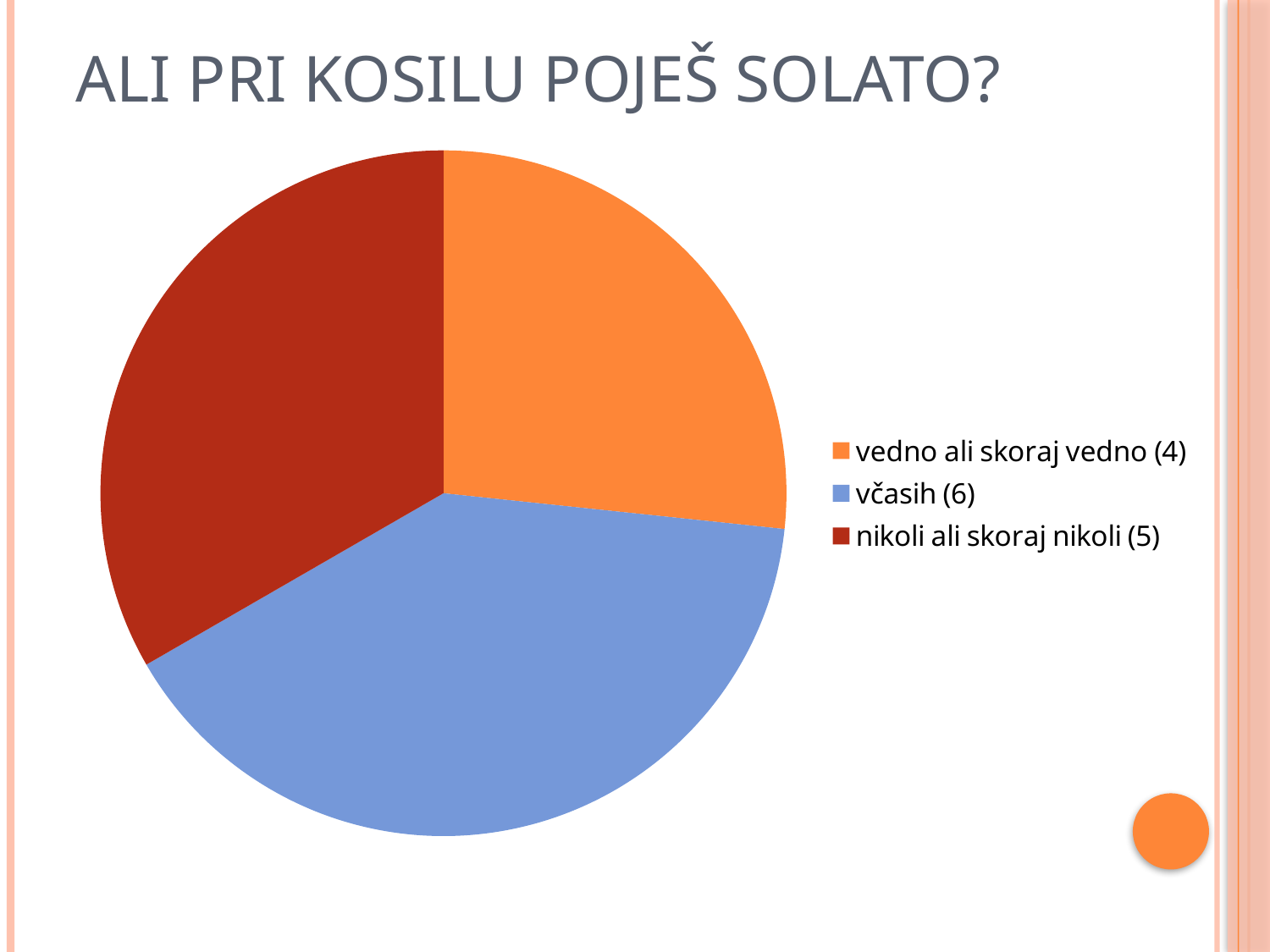
What share of the pie does "včasih" represent? 40% What is the value for "vedno ali skoraj vedno"? 4 What kind of chart is shown on the slide? pie chart How many slices does the pie chart have? 3 Which category has the smallest slice? vedno ali skoraj vedno Which is larger, the value for "nikoli ali skoraj nikoli" or the value for "vedno ali skoraj vedno"? nikoli ali skoraj nikoli What is the value for "nikoli ali skoraj nikoli"? 5 What is the value for "včasih"? 6 What is the difference between the values for "včasih" and "vedno ali skoraj vedno"? 2 Which category has the largest slice? včasih What is the title of the chart? ALI PRI KOSILU POJEŠ SOLATO? How many entries does the legend list? 3